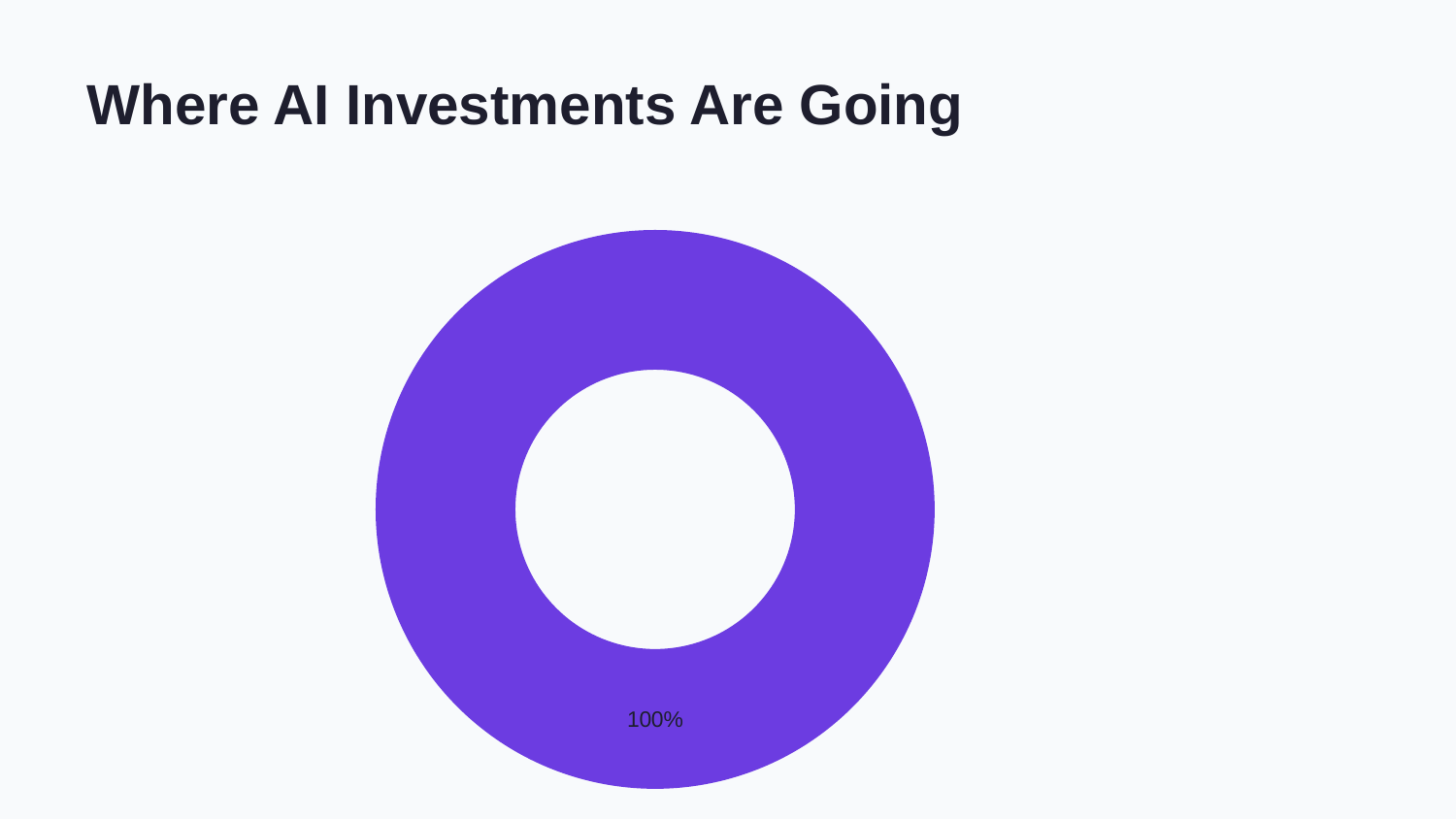
How many slices does the doughnut chart contain? 1 What is the title of the slide containing the doughnut chart? Where AI Investments Are Going What kind of chart is shown on the slide? doughnut chart What colour is the slice of the doughnut chart? purple What percentage is printed on the single slice of the doughnut chart? 100%